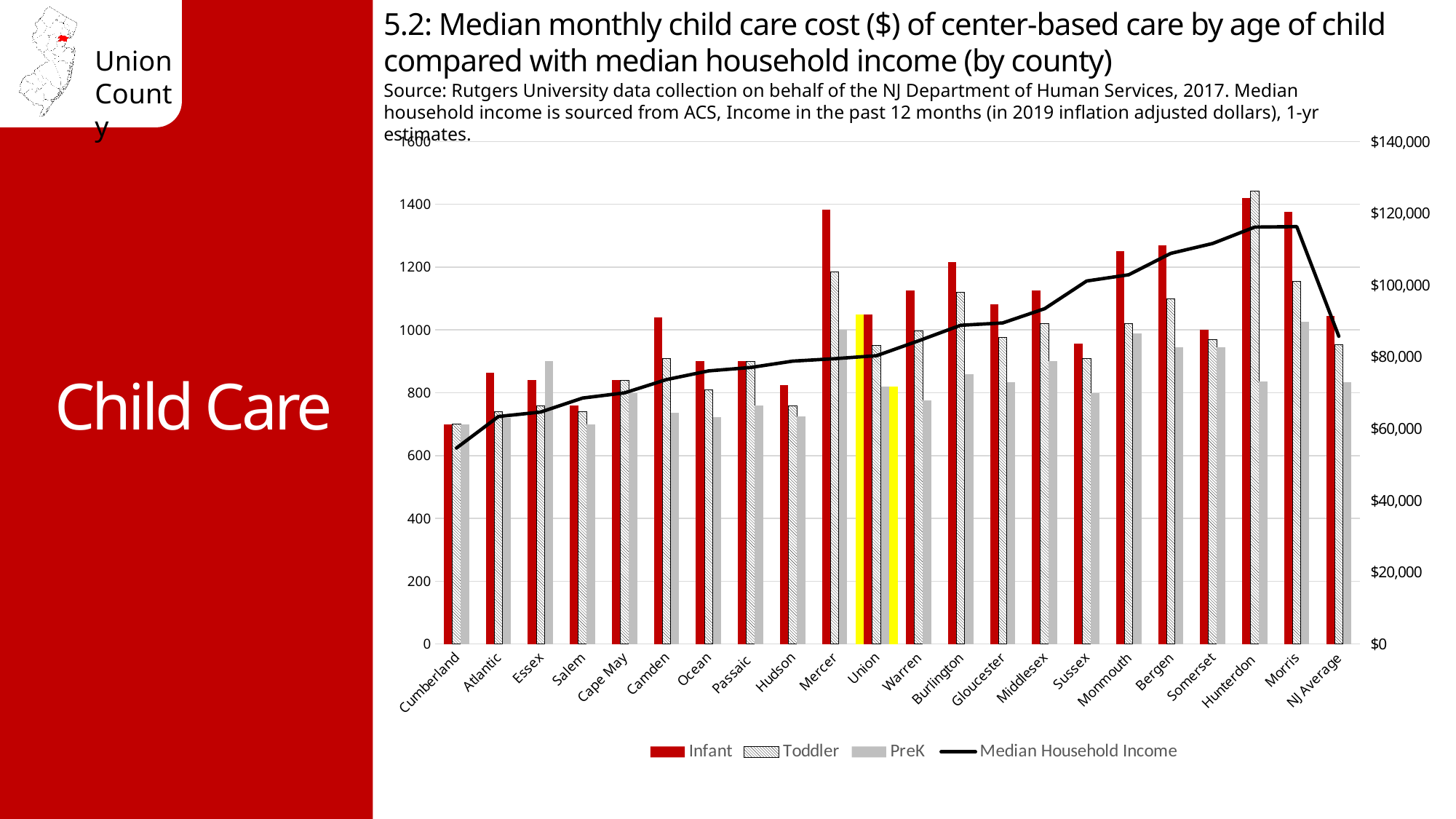
Is the PreK value for Union greater or less than 1000? less Which is larger, the Infant value for Mercer or the Infant value for Union? Mercer How many series does the legend list? 4 Which category's bars are highlighted in yellow? Union Which category has the highest Toddler bar? Hunterdon Is the Median Household Income for Morris greater or less than $100,000? greater Is the Infant value for Mercer greater or less than 1200? greater What kind of chart is this? Bar chart with a line How many counties/categories are shown along the x axis? 22 Which category has the highest Infant bar? Hunterdon Does the Median Household Income line generally rise or fall from Cumberland to Morris? rise Which category has the lowest Infant bar? Cumberland